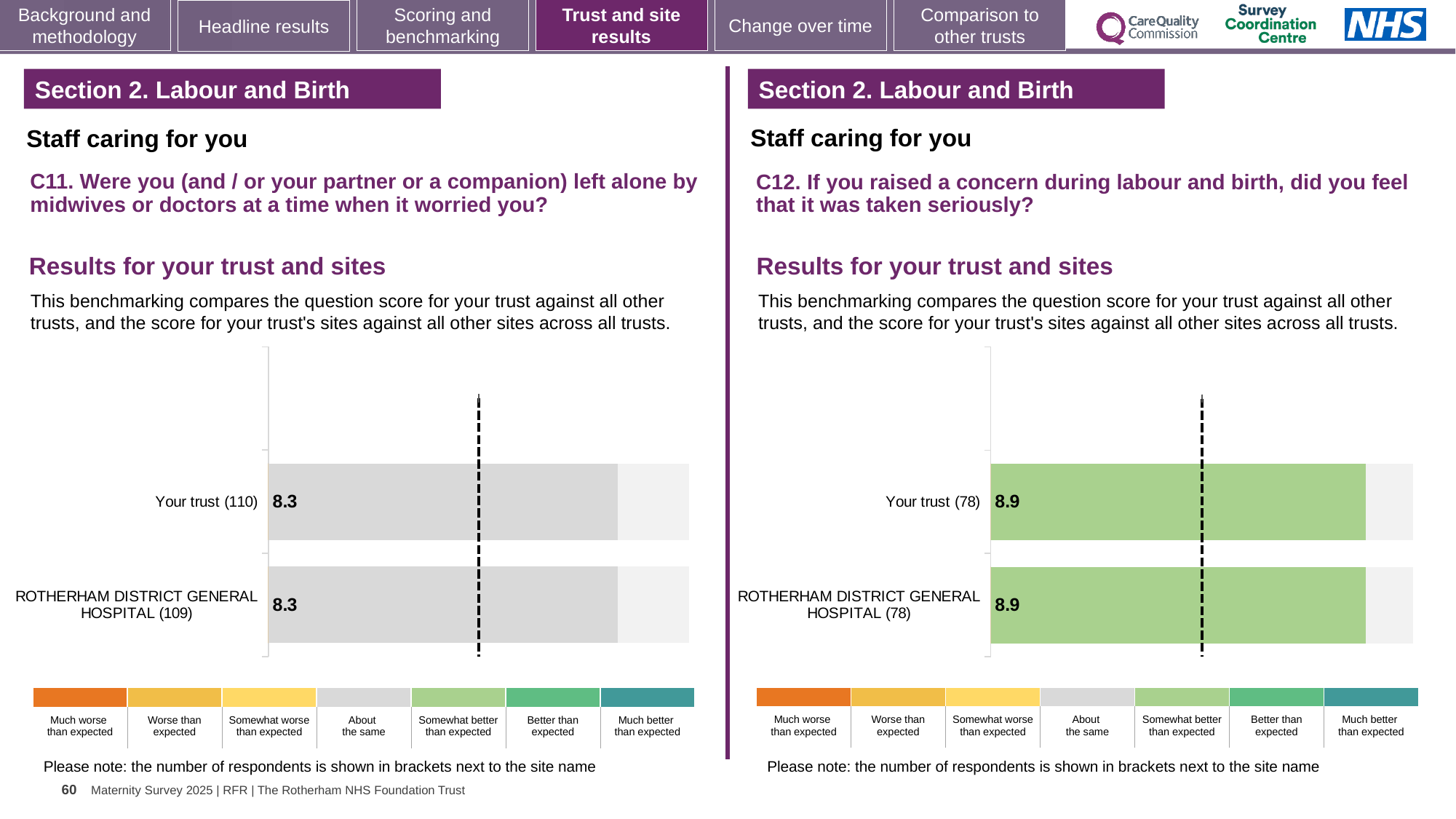
In the C11 chart on the left, what is the score for Your trust? 8.3 How many respondents are shown in brackets for Your trust in the C11 chart on the left? 110 In the C11 chart on the left, what is the difference between the Your trust score and the ROTHERHAM DISTRICT GENERAL HOSPITAL score? 0 How many bars are plotted in the C12 chart on the right? 2 In the C11 chart on the left, what is the score for ROTHERHAM DISTRICT GENERAL HOSPITAL? 8.3 In the C12 chart on the right, what is the difference between the Your trust score and the ROTHERHAM DISTRICT GENERAL HOSPITAL score? 0 In the C12 chart on the right, what is the score for Your trust? 8.9 According to the legend, which benchmark category does the light green colour of the bars in the C12 chart on the right represent? Somewhat better than expected How many bars are plotted in the C11 chart on the left? 2 What type of chart is used for the C12 results on the right? Bar chart How many respondents are shown in brackets for ROTHERHAM DISTRICT GENERAL HOSPITAL in the C12 chart on the right? 78 In the C12 chart on the right, what is the score for ROTHERHAM DISTRICT GENERAL HOSPITAL? 8.9